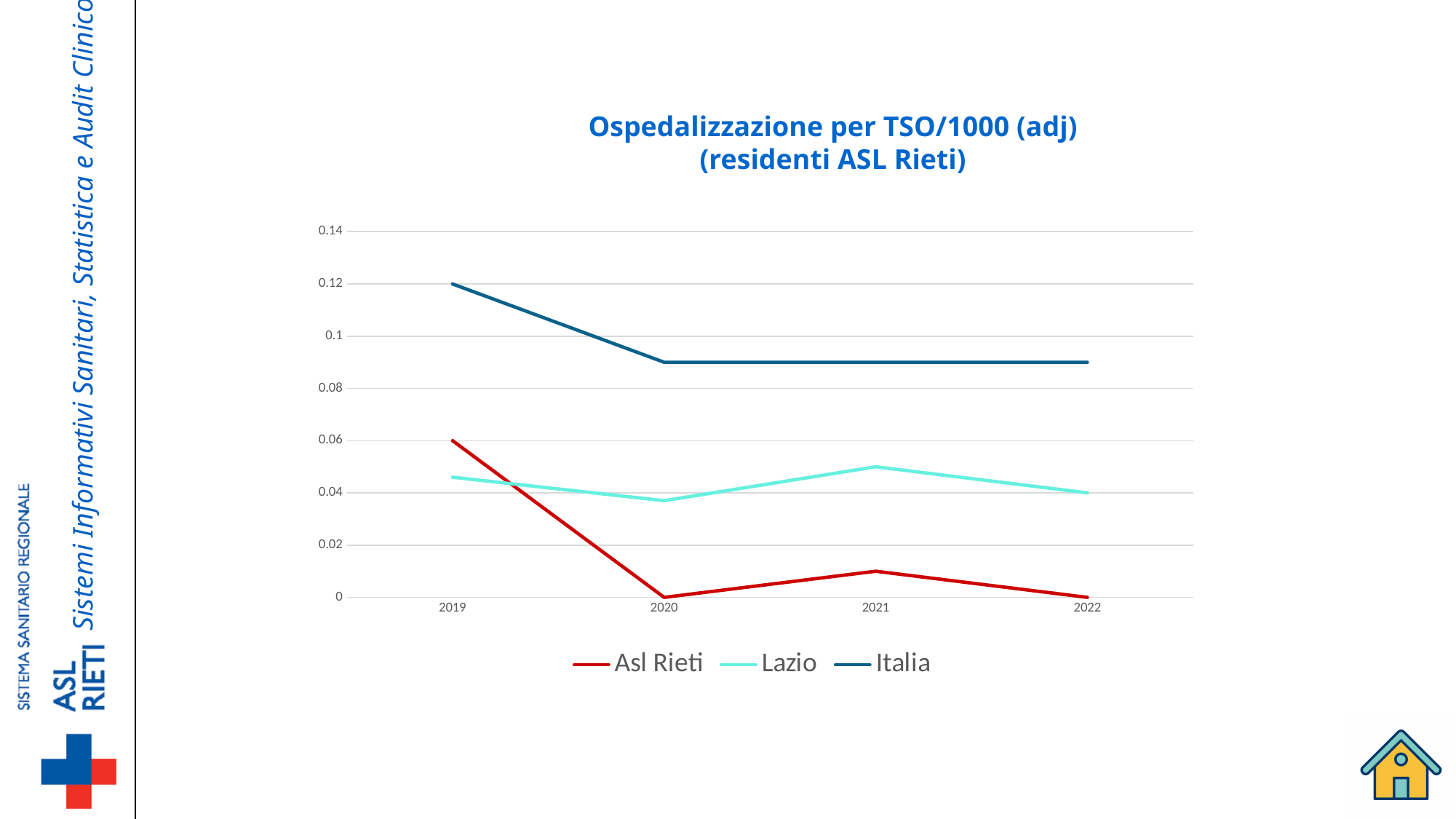
Is the value for Italia in 2020 greater or less than 0.08? greater Does the Asl Rieti line rise or fall from 2019 to 2020? Fall What is the difference between the Italia and Asl Rieti values in 2019? 0.06 What is the value for Asl Rieti in 2020? 0 What type of chart is shown on the slide? Line chart How many series does the legend list? 3 What is the value for Italia in 2019? 0.12 How many years are plotted along the x axis? 4 Which series has the highest value in 2019? Italia What is the value for Asl Rieti in 2019? 0.06 Is the value for Asl Rieti in 2021 greater or less than 0.02? less What is the value for Lazio in 2022? 0.04